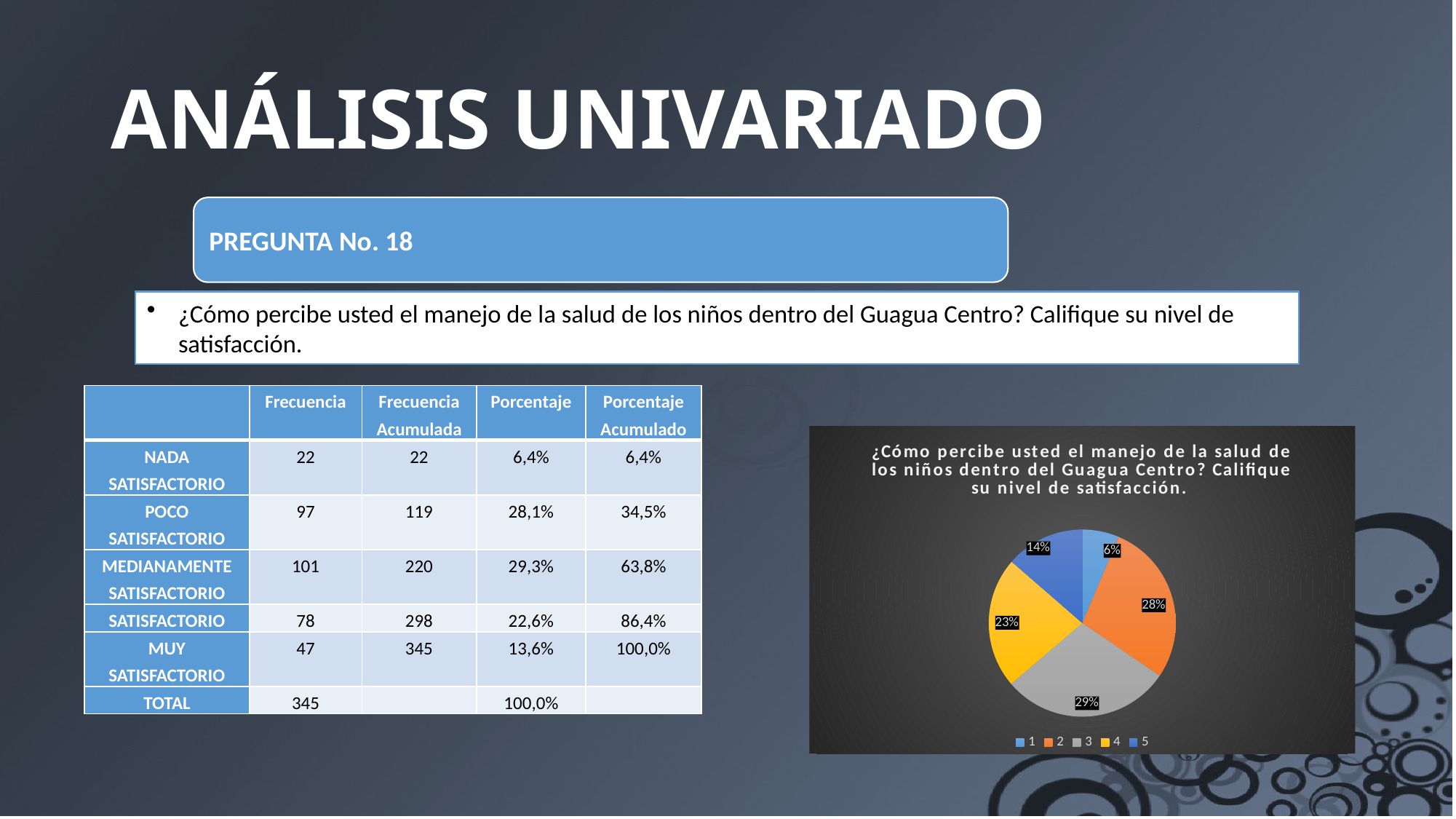
What percentage does the slice for category 5 show in the pie chart? 14% What percentage does the slice for category 3 show in the pie chart? 29% Which slice is larger in the pie chart, category 4 or category 5? 4 What colour is the slice for category 3 in the pie chart? gray How many entries does the legend of the pie chart list? 5 What is the difference in percentage points between the slices for category 3 and category 1 in the pie chart? 23 What kind of chart is shown on the slide? pie chart What percentage does the slice for category 2 show in the pie chart? 28% What percentage does the slice for category 1 show in the pie chart? 6% How many slices does the pie chart have? 5 Which category has the largest slice in the pie chart? 3 Which category has the smallest slice in the pie chart? 1